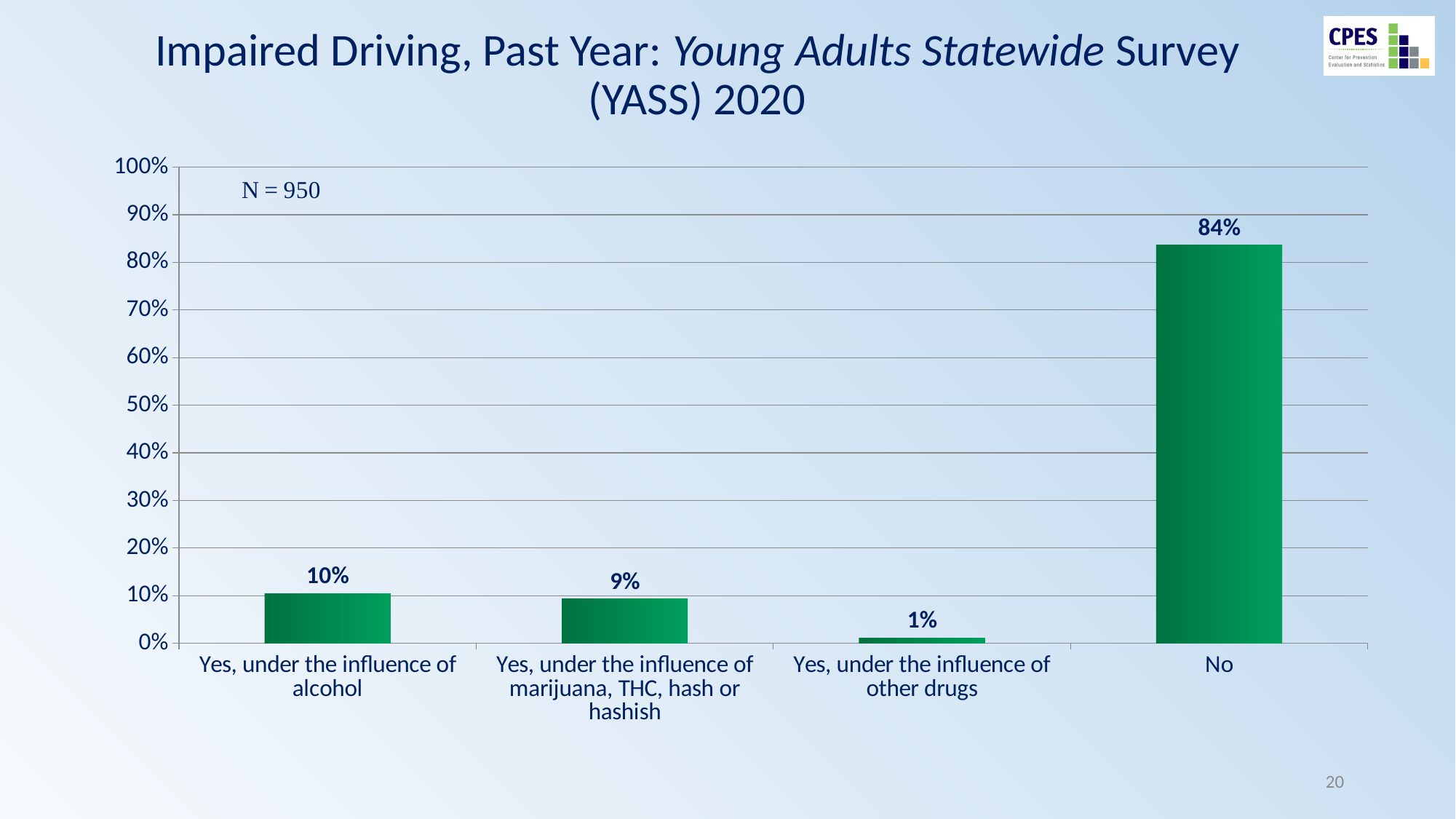
What kind of chart is shown on the slide? Bar chart Which category has the lowest value? Yes, under the influence of other drugs What is the difference between the 'No' value and the 'Yes, under the influence of alcohol' value? 74% What is the value for 'Yes, under the influence of other drugs'? 1% What is the difference between the alcohol value and the marijuana, THC, hash or hashish value? 1% Is the value for 'No' greater or less than 80%? greater How many categories are shown on the x axis? 4 What is the value for 'Yes, under the influence of marijuana, THC, hash or hashish'? 9% Which is larger: the value for alcohol or the value for other drugs? Yes, under the influence of alcohol Which category has the highest value? No What percentage of respondents answered 'No'? 84% What percentage of respondents reported driving under the influence of alcohol in the past year? 10%